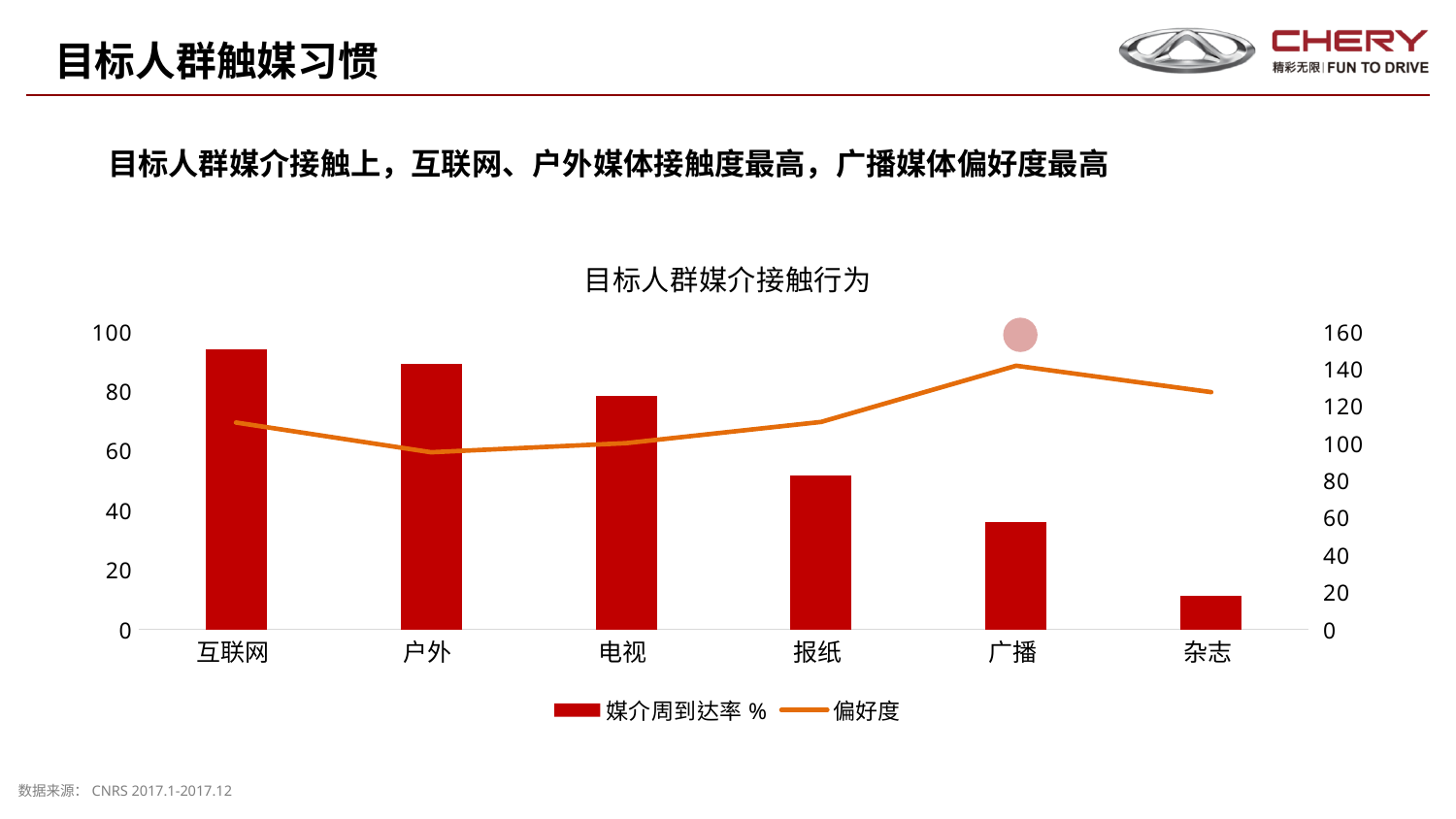
Which has a larger 媒介周到达率 % bar, 广播 or 杂志? 广播 Is the 媒介周到达率 % value for 报纸 greater or less than 60? less Which category has the highest 媒介周到达率 % bar? 互联网 Which category has the highest 偏好度 value on the line? 广播 How many media categories are shown on the x axis? 6 Do the 媒介周到达率 % bars rise or fall from 互联网 to 杂志 along the x axis? fall Which series is drawn as a line in the chart? 偏好度 Is the 媒介周到达率 % value for 电视 greater or less than 60? greater What is the title of the chart? 目标人群媒介接触行为 Is the 偏好度 value for 广播 greater or less than 120? greater Which category has the lowest 媒介周到达率 % bar? 杂志 How many series does the chart legend list? 2